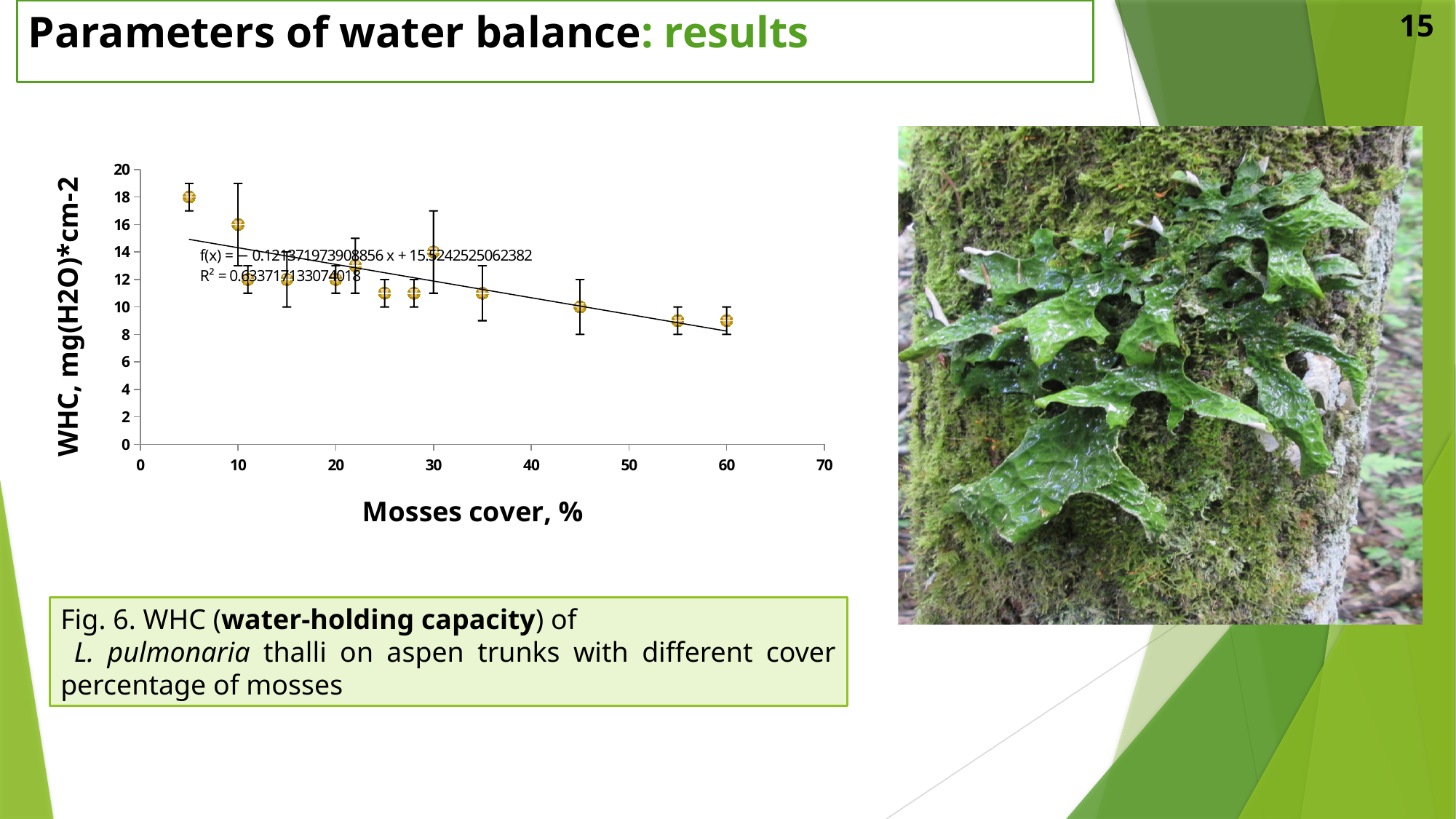
Is the WHC value at 60% mosses cover greater or less than 10? less At which mosses cover percentage is WHC highest? 5 What is the difference between the WHC values at 5% and 10% mosses cover? 2 What is the WHC value at 45% mosses cover? 10 Which has the larger WHC value: 5% mosses cover or 60% mosses cover? 5% What is the WHC value at 5% mosses cover? 18 What is the WHC value at 10% mosses cover? 16 What is the title of the y axis? WHC, mg(H2O)*cm-2 What is the WHC value at 30% mosses cover? 14 What kind of chart is shown on the slide? scatter chart What is the title of the x axis? Mosses cover, % Do the WHC values generally rise or fall as mosses cover increases? fall